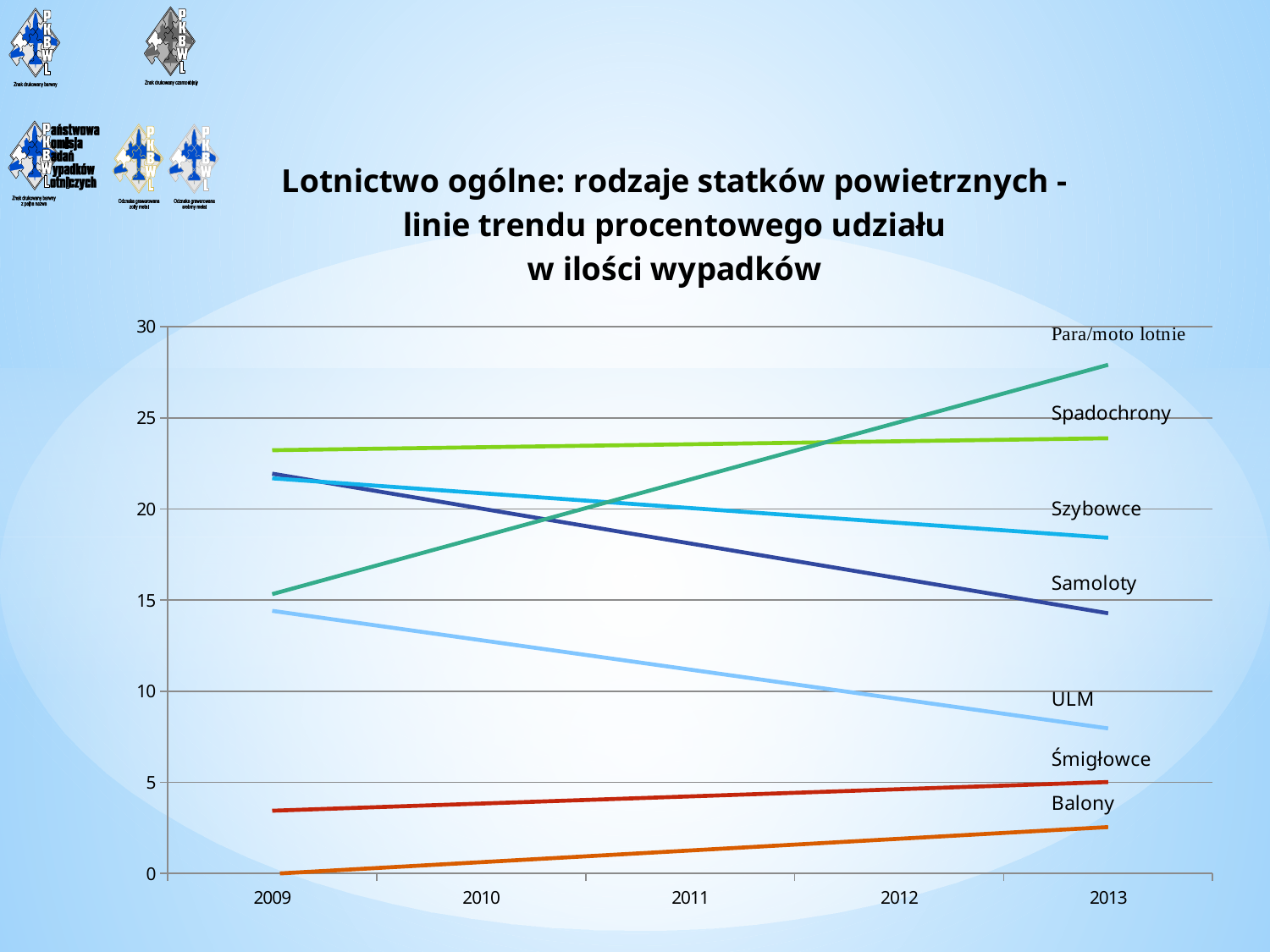
Is the value for ULM in 2013 greater or less than 10? less Is the value for Spadochrony in 2013 greater or less than 20? greater Does the trend line for Samoloty rise or fall from 2009 to 2013? fall How many years are shown on the x axis of the chart? 5 What kind of chart is shown on the slide? line chart Does the trend line for Para/moto lotnie rise or fall from 2009 to 2013? rise Which category has the highest trend line value in 2013? Para/moto lotnie In 2013, which is larger: the value for Szybowce or the value for Samoloty? Szybowce Which category has the lowest trend line value in 2009? Balony Does the trend line for Balony rise or fall from 2009 to 2013? rise How many aircraft categories have trend lines on the chart? 7